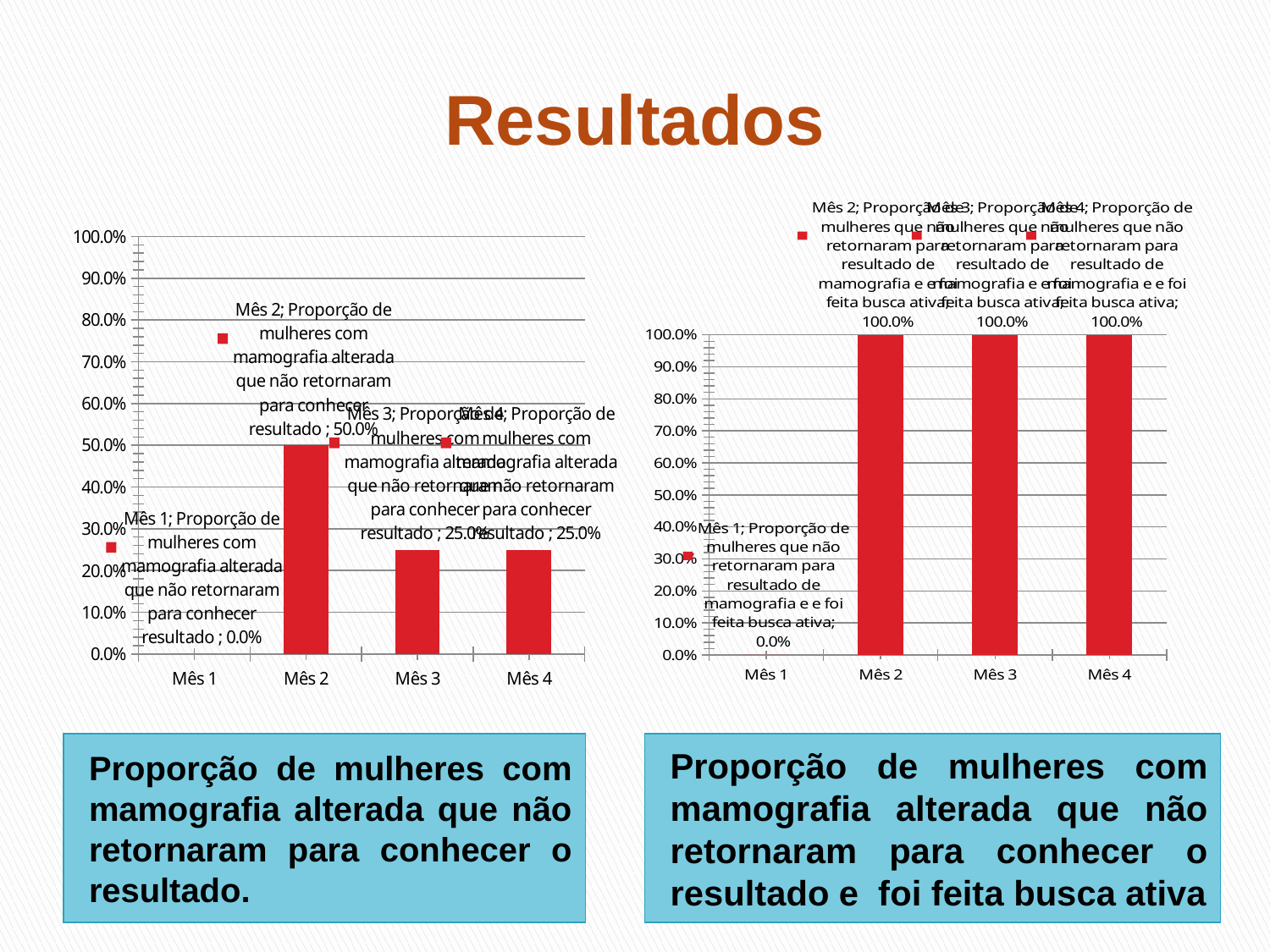
In the right chart, is the value for Mês 2 larger or smaller than the value for Mês 1? larger In the right chart, what is the value for Mês 1? 0.0% In the right chart, which month has the lowest value? Mês 1 How many months are shown on the x axis of the left chart? 4 In the left chart, what is the value for Mês 2? 50.0% What type of chart is the right chart? bar chart In the left chart, which month has the highest value? Mês 2 In the right chart, what is the value for Mês 4? 100.0% In the left chart, what is the value for Mês 3? 25.0% In the left chart, what is the difference between the values for Mês 2 and Mês 3? 25.0% In the left chart, what is the value for Mês 1? 0.0% In the left chart, which month has the lowest value? Mês 1